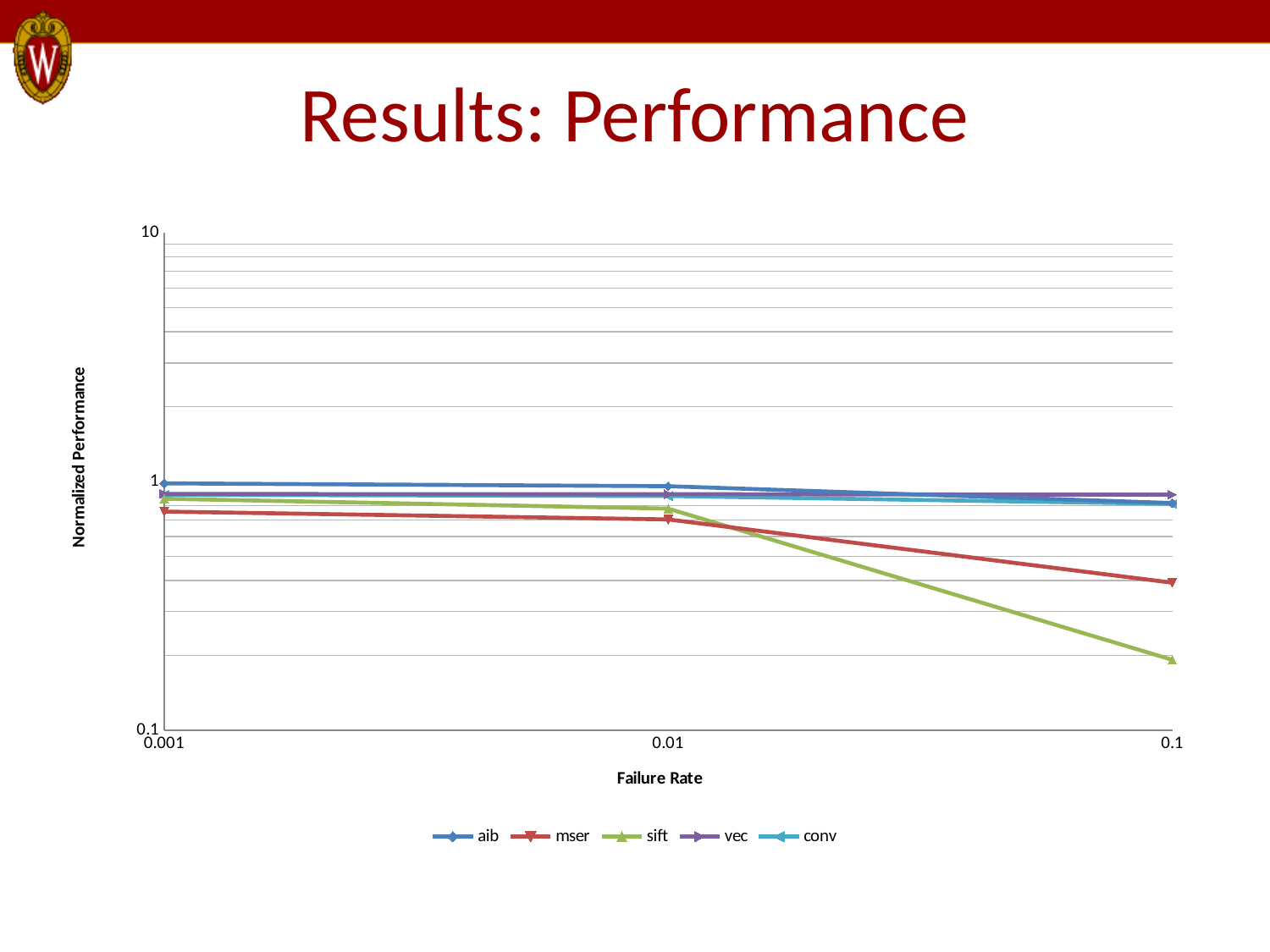
Which series has the lowest normalized performance at a failure rate of 0.001? mser How many series does the legend list? 5 How many failure rate values are plotted along the x axis? 3 Does the normalized performance for sift rise or fall as the failure rate increases from 0.001 to 0.1? fall Which series has the lowest normalized performance at a failure rate of 0.1? sift What is the label of the x axis? Failure Rate What is the label of the y axis? Normalized Performance Is the normalized performance for sift at a failure rate of 0.1 greater or less than 1? less Does the normalized performance for mser rise or fall as the failure rate increases from 0.01 to 0.1? fall What kind of chart is shown on the slide? line chart At a failure rate of 0.1, which series has the larger normalized performance, mser or sift? mser Is the normalized performance for mser at a failure rate of 0.1 greater or less than 0.1? greater